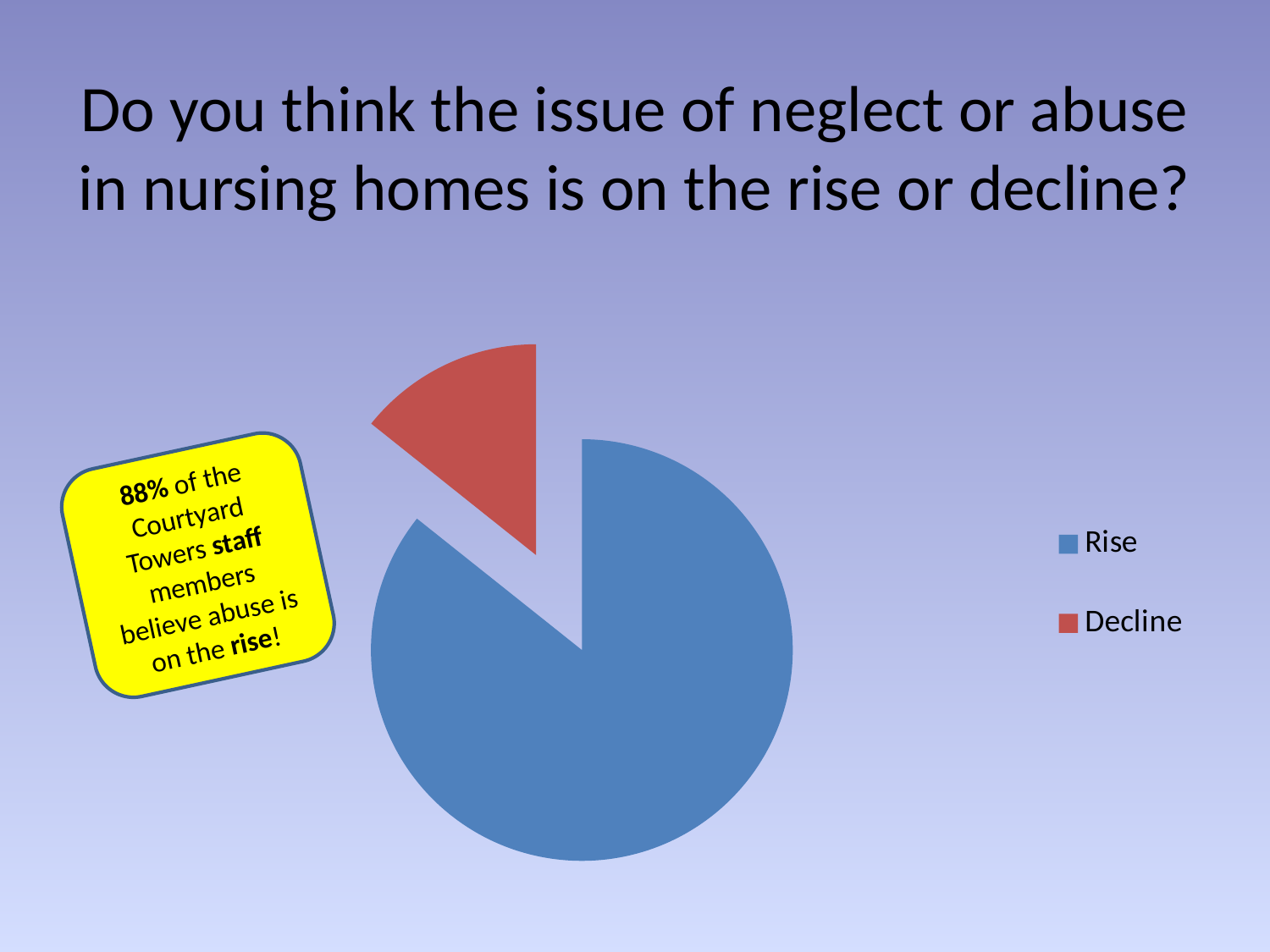
Which category has the smallest slice of the pie chart? Decline How many entries does the legend of the pie chart list? 2 Which slice is larger, Rise or Decline? Rise Which slice of the pie chart is pulled out (exploded) from the rest? Decline Which category has the largest slice of the pie chart? Rise What kind of chart is shown on the slide? pie chart How many slices does the pie chart have? 2 What share of the pie does the Rise slice represent, according to the slide? 88% What colour is the Rise slice in the pie chart? blue